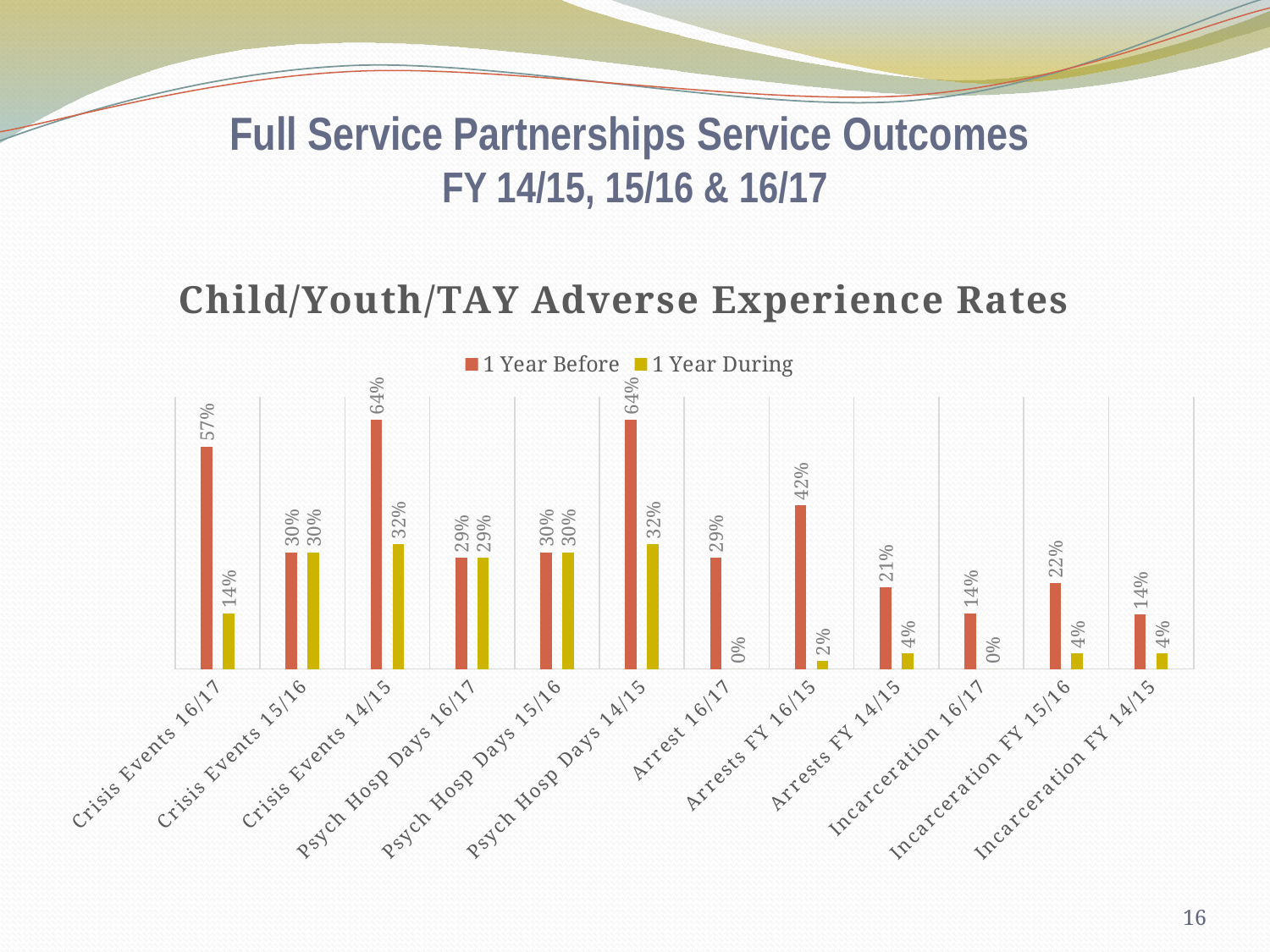
What is the 1 Year During value for Arrests FY 16/15? 2% What is the difference between the 1 Year Before and 1 Year During values for Crisis Events 16/17? 43 percentage points What is the 1 Year Before value for Crisis Events 16/17? 57% What kind of chart is shown on the slide? Bar chart What is the 1 Year Before value for Incarceration FY 15/16? 22% What is the difference between the 1 Year Before and 1 Year During values for Psych Hosp Days 14/15? 32 percentage points What is the 1 Year During value for Arrest 16/17? 0% How many series does the legend list? 2 What are the two series named in the legend? 1 Year Before and 1 Year During Which has the larger 1 Year Before value, Arrests FY 16/15 or Arrests FY 14/15? Arrests FY 16/15 How many categories are shown on the x axis of the chart? 12 Which has the larger 1 Year During value, Crisis Events 16/17 or Crisis Events 14/15? Crisis Events 14/15